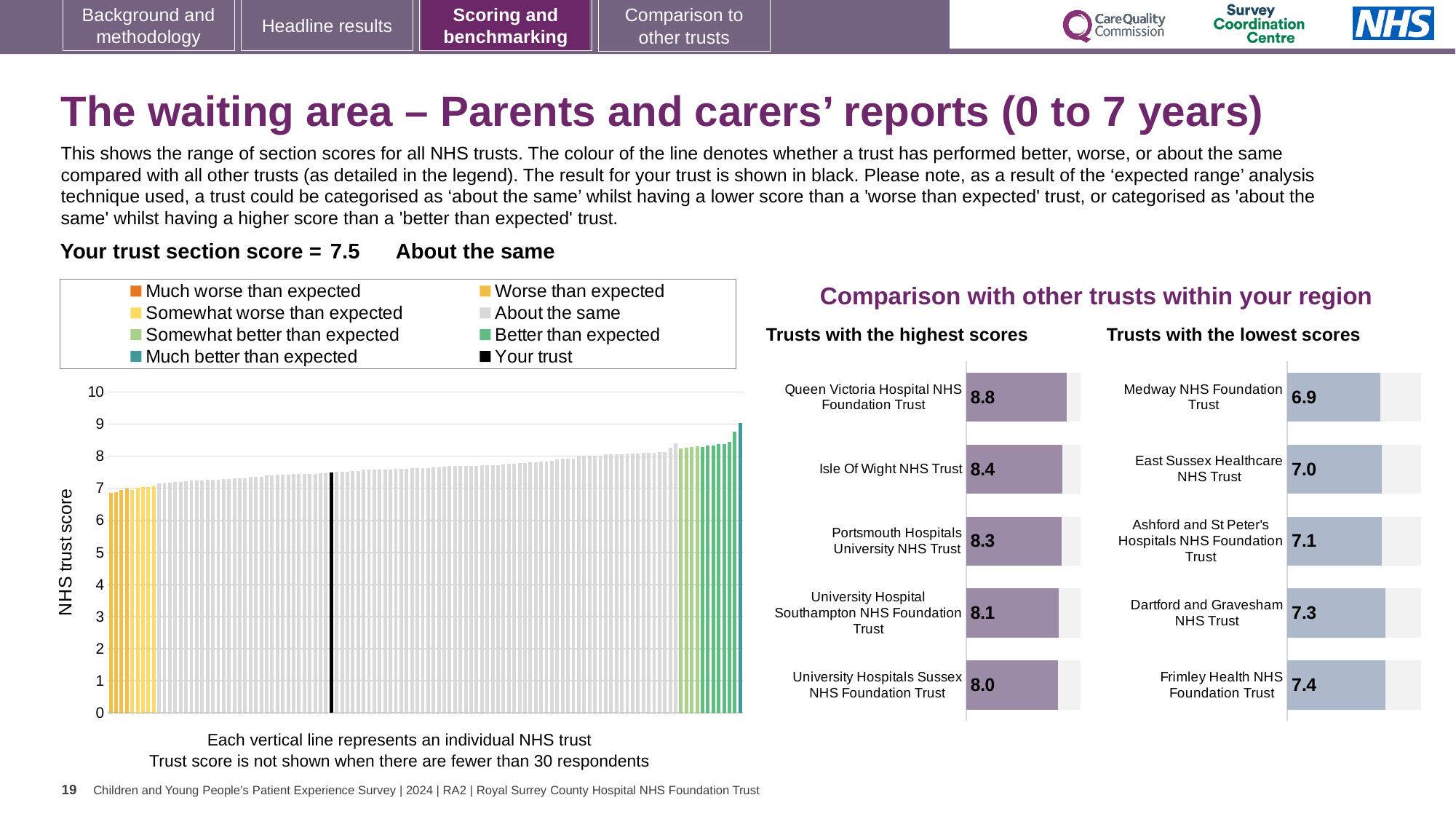
In the 'Trusts with the highest scores' chart, what is the score for Portsmouth Hospitals University NHS Trust? 8.3 In the 'Trusts with the lowest scores' chart, which has the larger score: East Sussex Healthcare NHS Trust or Dartford and Gravesham NHS Trust? Dartford and Gravesham NHS Trust In the 'Trusts with the highest scores' chart, what is the score for Queen Victoria Hospital NHS Foundation Trust? 8.8 How many entries does the legend of the main chart on the left list? 8 In the 'Trusts with the highest scores' chart, what is the difference between the scores of Queen Victoria Hospital NHS Foundation Trust and Isle Of Wight NHS Trust? 0.4 In the 'Trusts with the highest scores' chart, which trust has the lowest score? University Hospitals Sussex NHS Foundation Trust In the 'Trusts with the lowest scores' chart, which trust has the highest score? Frimley Health NHS Foundation Trust How many trusts are shown in the 'Trusts with the lowest scores' chart? 5 In the 'Trusts with the lowest scores' chart, what is the score for Medway NHS Foundation Trust? 6.9 In the main chart on the left showing all NHS trusts, do the bar values rise or fall from left to right? Rise What kind of chart is the main chart on the left showing all NHS trusts? Bar chart In the main chart on the left showing all NHS trusts, what is the section score for your trust (the black bar)? 7.5